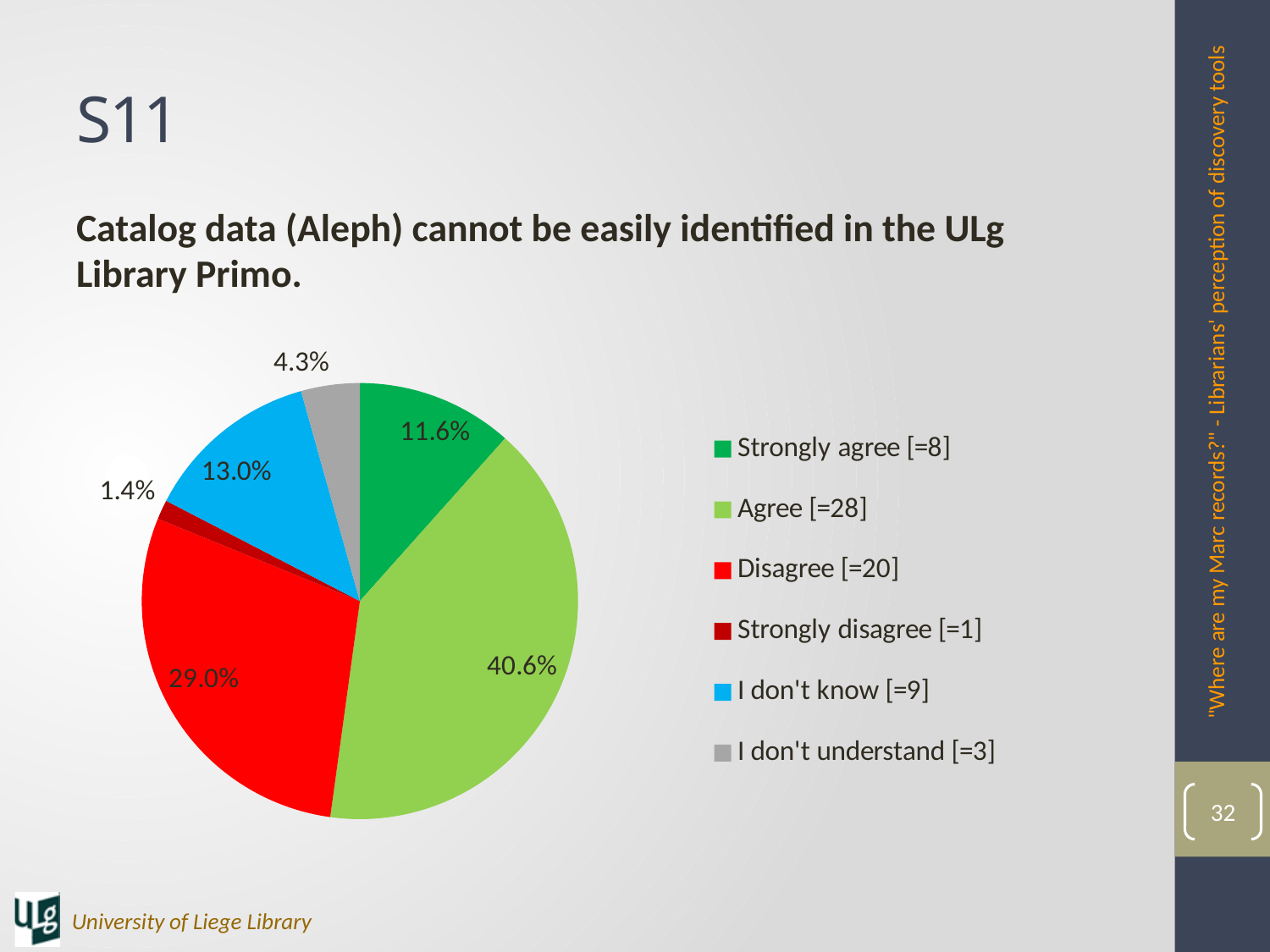
How many respondents does the legend show for the Agree category? 28 What percentage of the pie does the Strongly agree slice represent? 11.6% What percentage of the pie does the I don't know slice represent? 13.0% Which category has the smallest slice of the pie? Strongly disagree What percentage of the pie does the Disagree slice represent? 29.0% What kind of chart is shown on the slide? pie chart Which category has the largest slice of the pie? Agree What is the difference in percentage points between the Agree slice and the Disagree slice? 11.6 Which is larger, the Disagree slice or the I don't know slice? Disagree How many categories does the pie chart have? 6